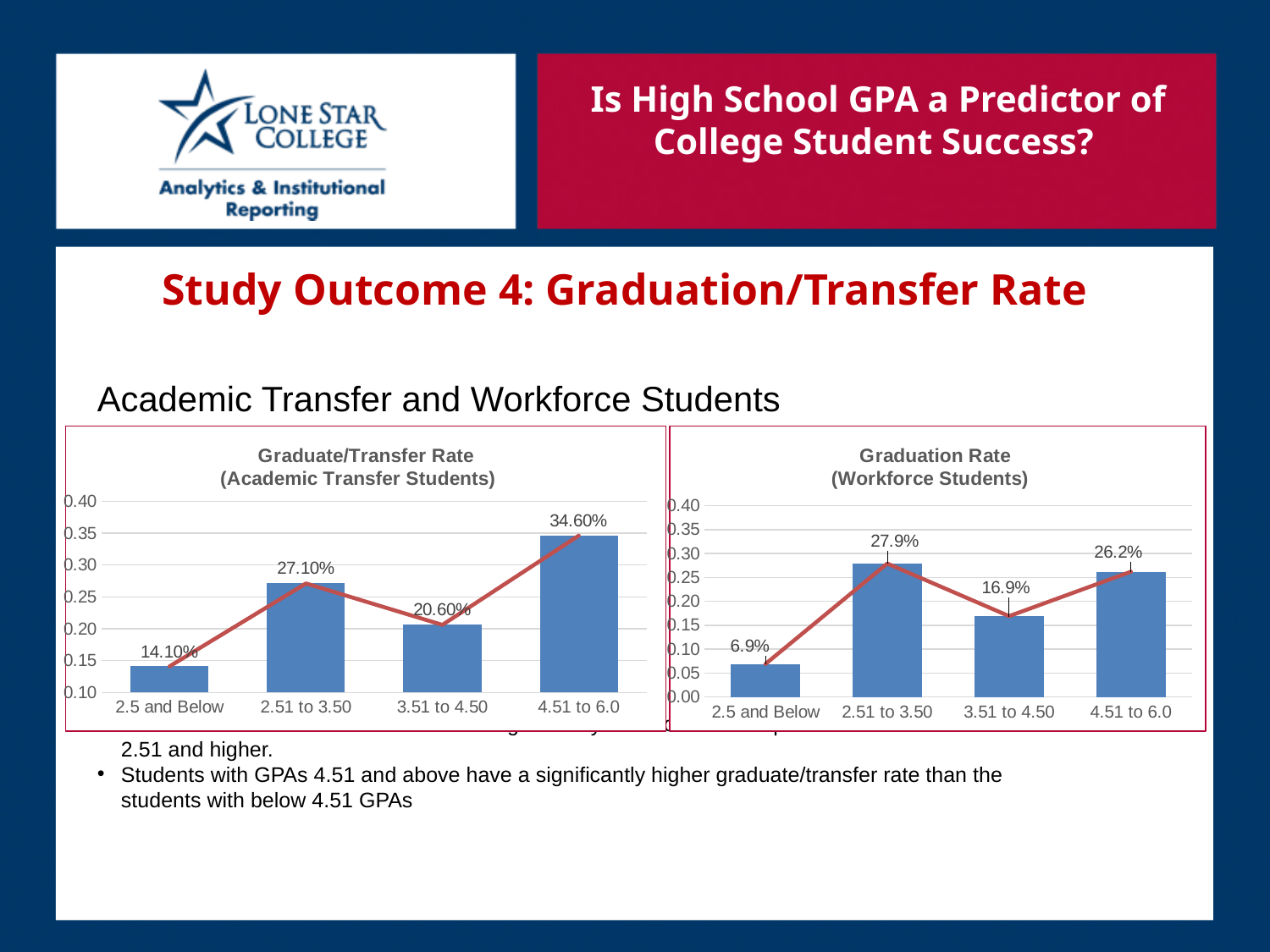
In the Graduation Rate (Workforce Students) chart, which GPA category has the lowest rate? 2.5 and Below In the Graduation Rate (Workforce Students) chart, what is the value for 3.51 to 4.50? 16.9% In the Graduate/Transfer Rate (Academic Transfer Students) chart, is the value for 3.51 to 4.50 greater or less than 0.25? less In the Graduate/Transfer Rate (Academic Transfer Students) chart, what is the value for 2.51 to 3.50? 27.10% In the Graduate/Transfer Rate (Academic Transfer Students) chart, does the value rise or fall from 2.51 to 3.50 to 3.51 to 4.50? fall In the Graduate/Transfer Rate (Academic Transfer Students) chart, what is the difference between the values for 4.51 to 6.0 and 2.5 and Below? 20.50% How many GPA categories are shown in the Graduation Rate (Workforce Students) chart? 4 In the Graduate/Transfer Rate (Academic Transfer Students) chart, which GPA category has the highest rate? 4.51 to 6.0 What is the title of the chart on the right side of the slide? Graduation Rate (Workforce Students) What kind of chart is the Graduate/Transfer Rate (Academic Transfer Students) chart? Bar chart with a line overlay In the Graduation Rate (Workforce Students) chart, what is the difference between the values for 2.51 to 3.50 and 3.51 to 4.50? 11.0% In the Graduation Rate (Workforce Students) chart, which is larger: the value for 2.51 to 3.50 or the value for 4.51 to 6.0? 2.51 to 3.50